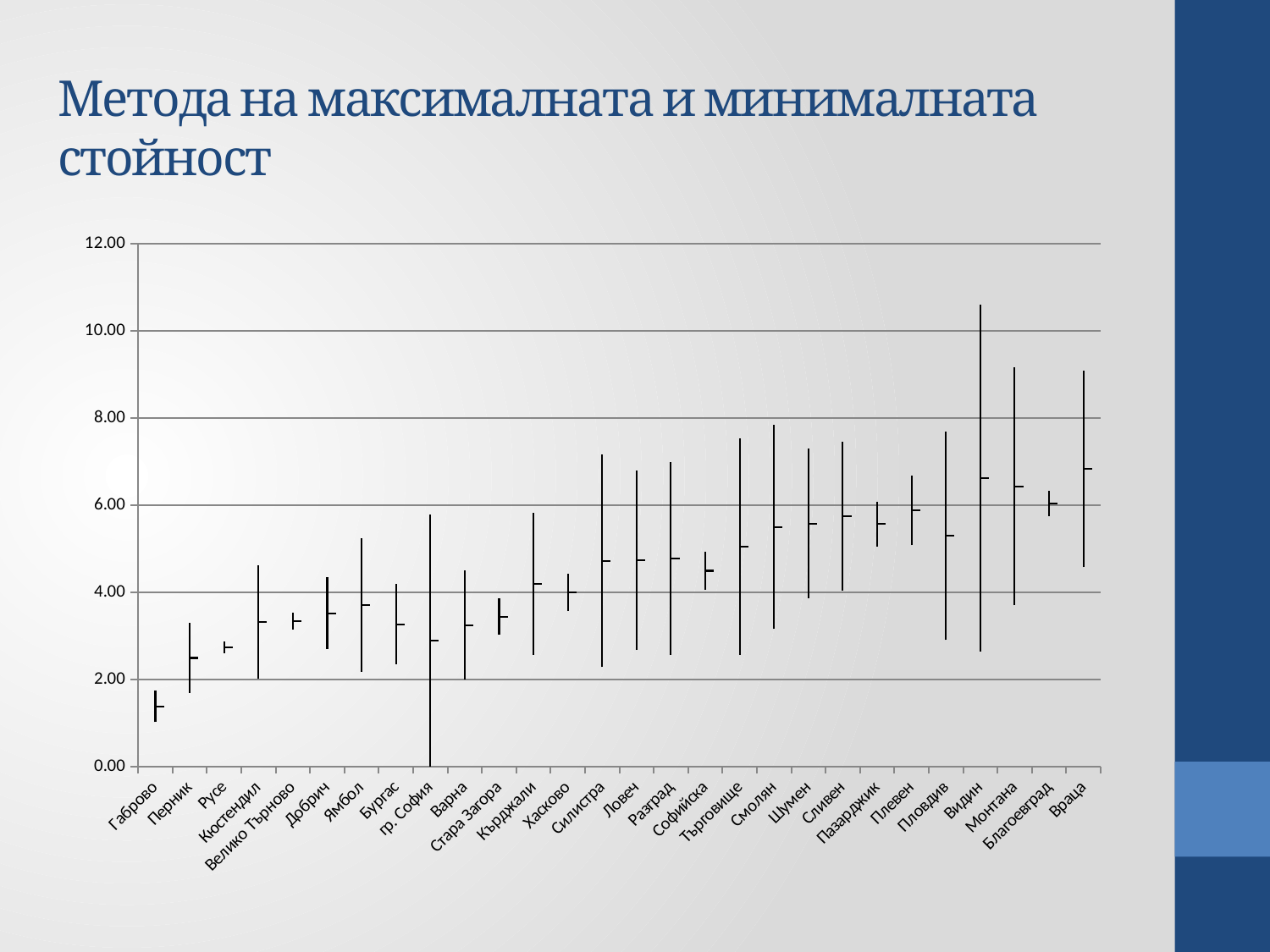
Do the values generally rise or fall moving from left to right along the x axis? rise Which has the higher marker value, Габрово or Перник? Перник What is the highest value shown on the vertical axis of the chart? 12.00 Is the maximum value for Враца greater or less than 8.00? greater Is the maximum value for Видин greater or less than 10.00? greater How many categories (regions) are shown along the x axis of the chart? 28 Is the minimum value for Монтана greater or less than 4.00? less Which has the higher maximum value, Видин or Монтана? Видин What kind of chart is shown on the slide? high-low (range) chart Which region has the highest maximum value on the chart? Видин Which region has the lowest minimum value on the chart? гр. София